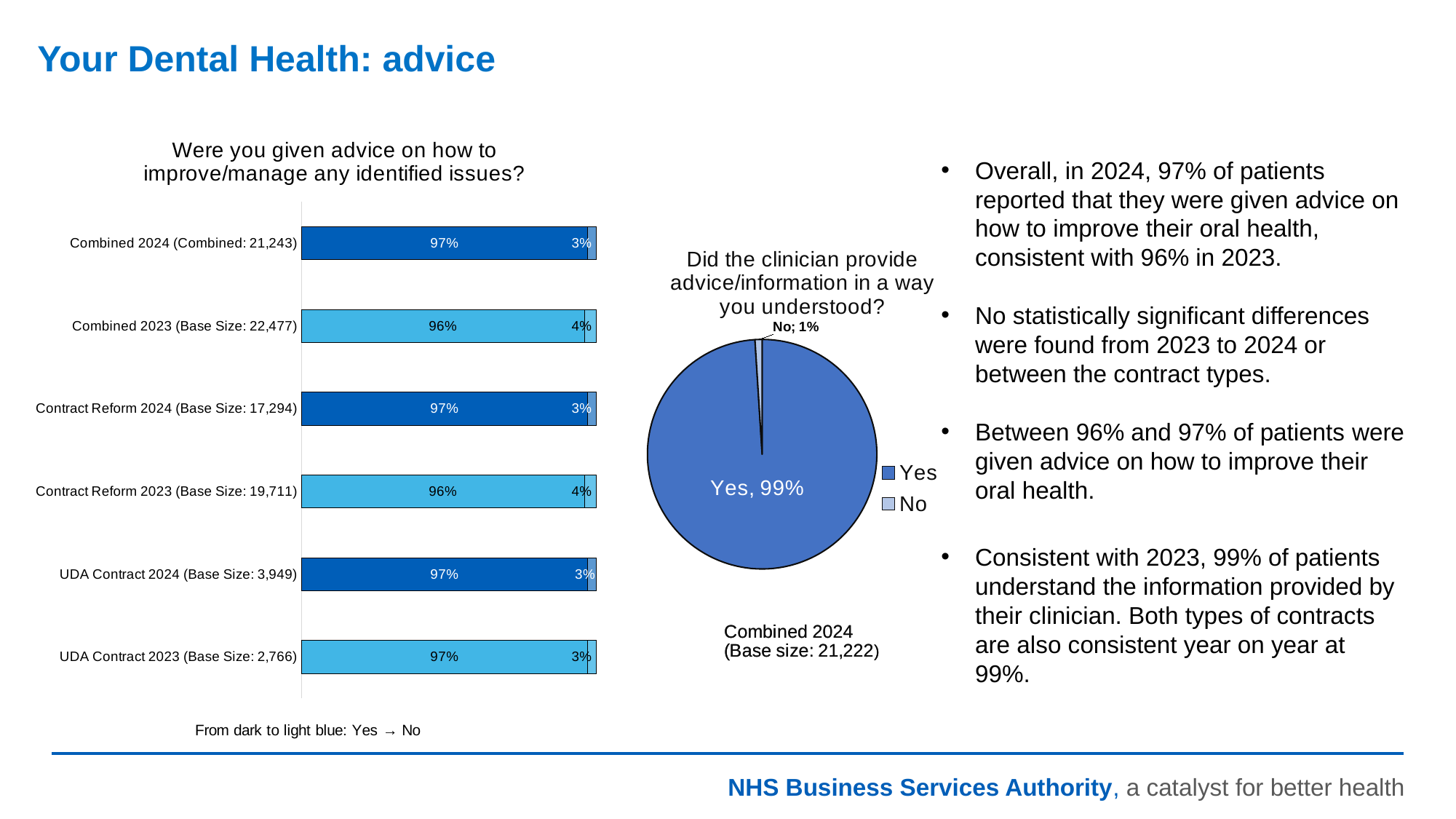
In the chart 'Were you given advice on how to improve/manage any identified issues?', what is the difference between the Yes value for Contract Reform 2024 and the Yes value for Contract Reform 2023? 1% In the chart 'Were you given advice on how to improve/manage any identified issues?', which is larger: the Yes value for Combined 2024 or the Yes value for Combined 2023? Combined 2024 In the chart 'Were you given advice on how to improve/manage any identified issues?', what is the total of the Yes and No segments for UDA Contract 2023? 100% In the chart 'Were you given advice on how to improve/manage any identified issues?', what is the Yes value for Combined 2024? 97% In the chart 'Were you given advice on how to improve/manage any identified issues?', what is the Yes value for Contract Reform 2023? 96% What kind of chart is 'Were you given advice on how to improve/manage any identified issues?' Stacked bar chart In the chart 'Were you given advice on how to improve/manage any identified issues?', what is the No value for Combined 2023? 4% How many entries does the legend of the pie chart 'Did the clinician provide advice/information in a way you understood?' list? 2 In the pie chart 'Did the clinician provide advice/information in a way you understood?', what share of patients answered No? 1% In the chart 'Were you given advice on how to improve/manage any identified issues?', how many categories (bars) are shown? 6 In the pie chart 'Did the clinician provide advice/information in a way you understood?', what share of patients answered Yes? 99% In the chart 'Were you given advice on how to improve/manage any identified issues?', what is the No value for UDA Contract 2024? 3%